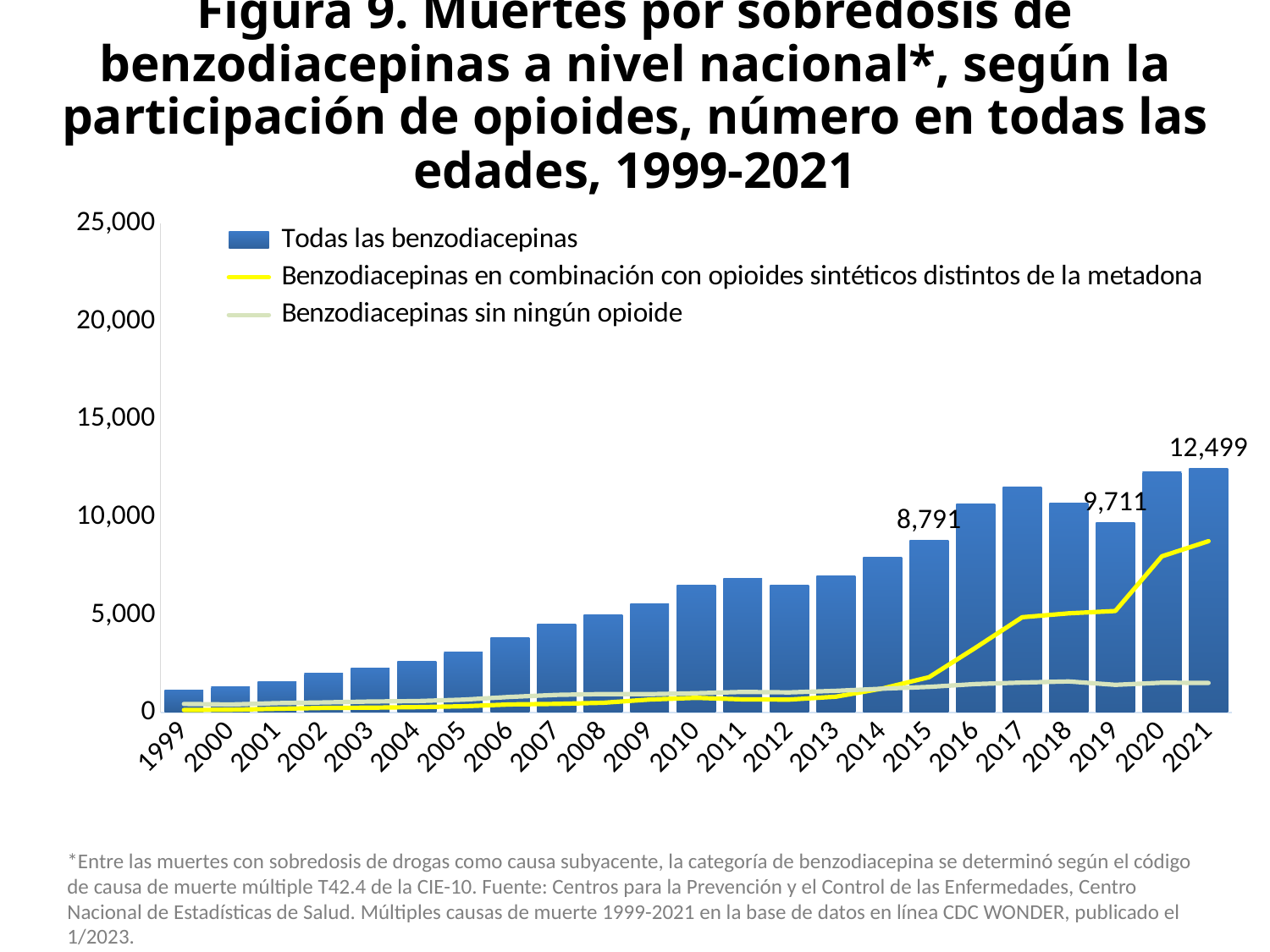
Which is larger, the Todas las benzodiacepinas value for 2018 or for 2019? 2018 What is the value for Todas las benzodiacepinas in 2019? 9,711 What is the difference between the Todas las benzodiacepinas values for 2021 and 2015? 3,708 How many series does the legend list? 3 How many years are shown on the x axis? 23 Which year has the lowest bar for Todas las benzodiacepinas? 1999 What is the difference between the Todas las benzodiacepinas values for 2019 and 2015? 920 Is the Todas las benzodiacepinas bar for 2005 greater or less than 5,000? less What is the value for Todas las benzodiacepinas in 2015? 8,791 Is the Todas las benzodiacepinas bar for 2017 greater or less than 10,000? greater What is the value for Todas las benzodiacepinas in 2021? 12,499 Which series is drawn as a yellow line? Benzodiacepinas en combinación con opioides sintéticos distintos de la metadona